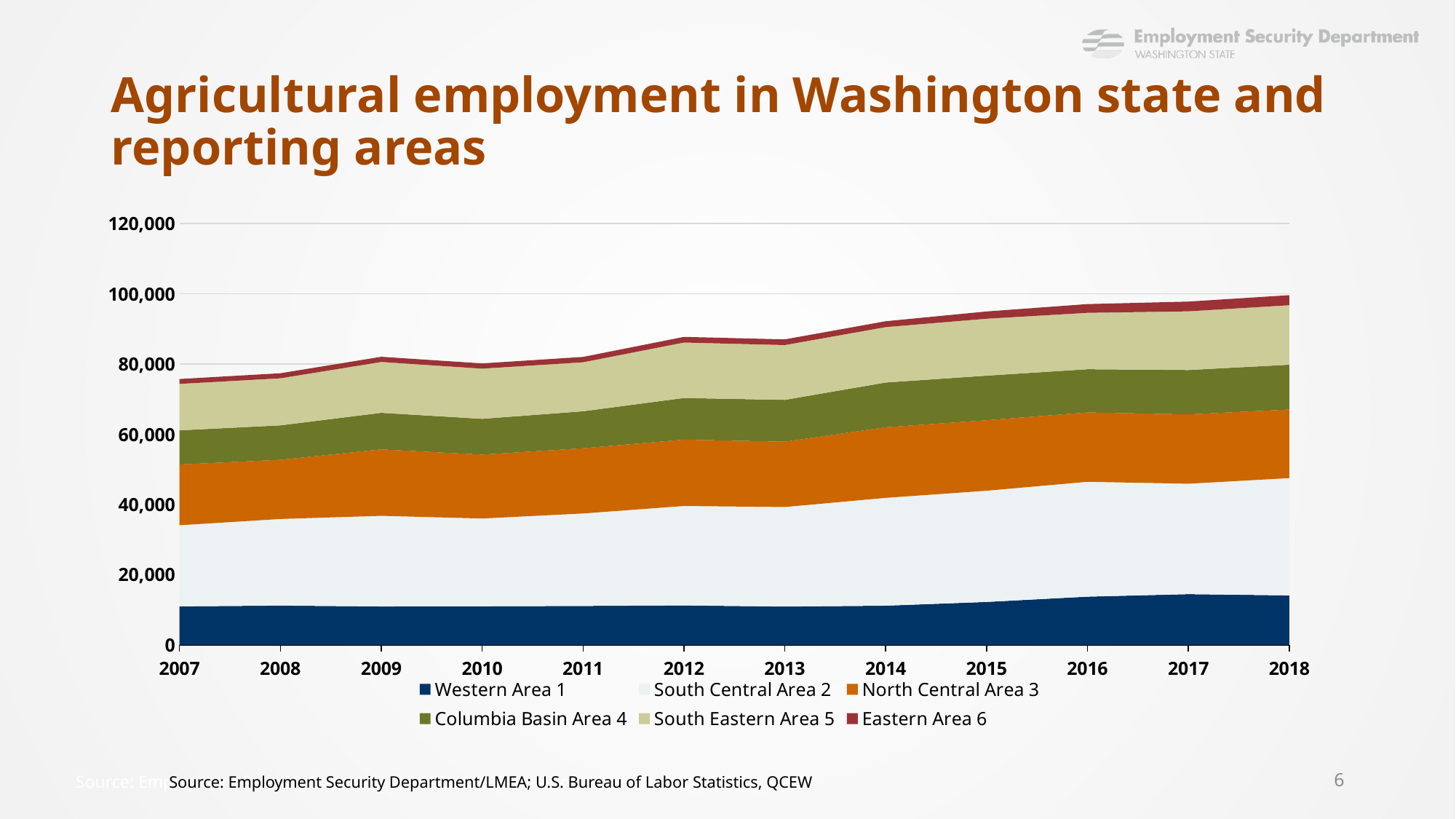
Is the value for Western Area 1 in 2007 greater or less than 20,000? less Does total agricultural employment generally rise or fall from 2007 to 2018? Rise Which year has the highest total agricultural employment? 2018 How many series does the legend list? 6 Is the total agricultural employment in 2012 greater or less than 100,000? less Is the total agricultural employment in 2014 greater or less than 80,000? greater What is the title of the slide containing the chart? Agricultural employment in Washington state and reporting areas Which year has the lowest total agricultural employment? 2007 How many years are plotted along the x axis? 12 What kind of chart is shown on the slide? Stacked area chart Which series is shown in dark blue at the bottom of the chart? Western Area 1